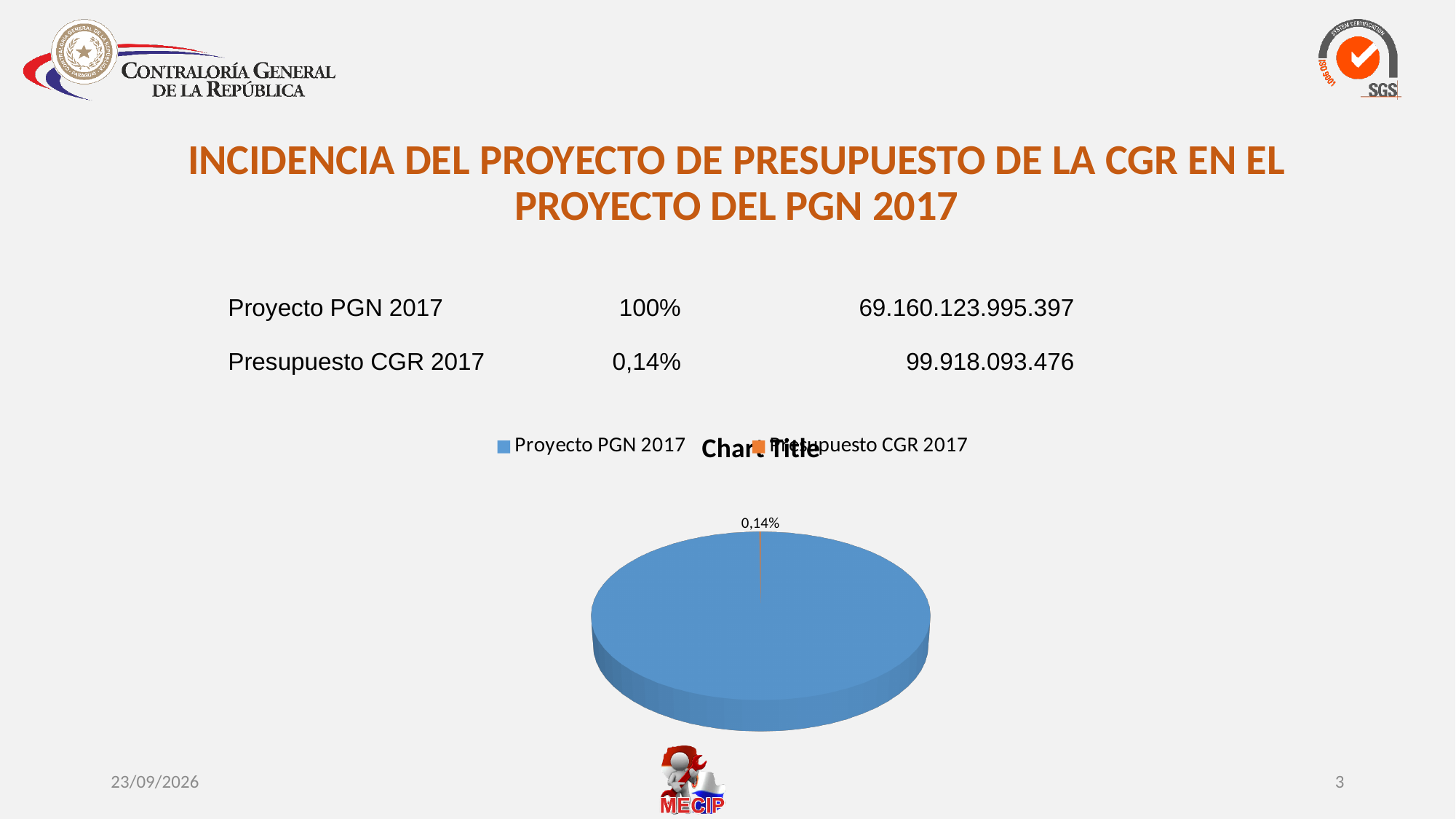
Which slice of the pie chart is the smallest? Presupuesto CGR 2017 What colour is the Proyecto PGN 2017 slice in the pie chart? blue Which slice of the pie chart is the largest? Proyecto PGN 2017 Which legend entry corresponds to the slice labelled 0,14%? Presupuesto CGR 2017 What colour is the Presupuesto CGR 2017 entry in the legend? orange What kind of chart is shown on the slide? pie chart How many slices does the pie chart have? 2 How many entries does the chart legend list? 2 What percentage is labelled on the small slice of the pie chart? 0,14% According to the text above the chart, what share of the Proyecto PGN 2017 does the Presupuesto CGR 2017 represent? 0,14% Which is larger in the pie chart, Proyecto PGN 2017 or Presupuesto CGR 2017? Proyecto PGN 2017